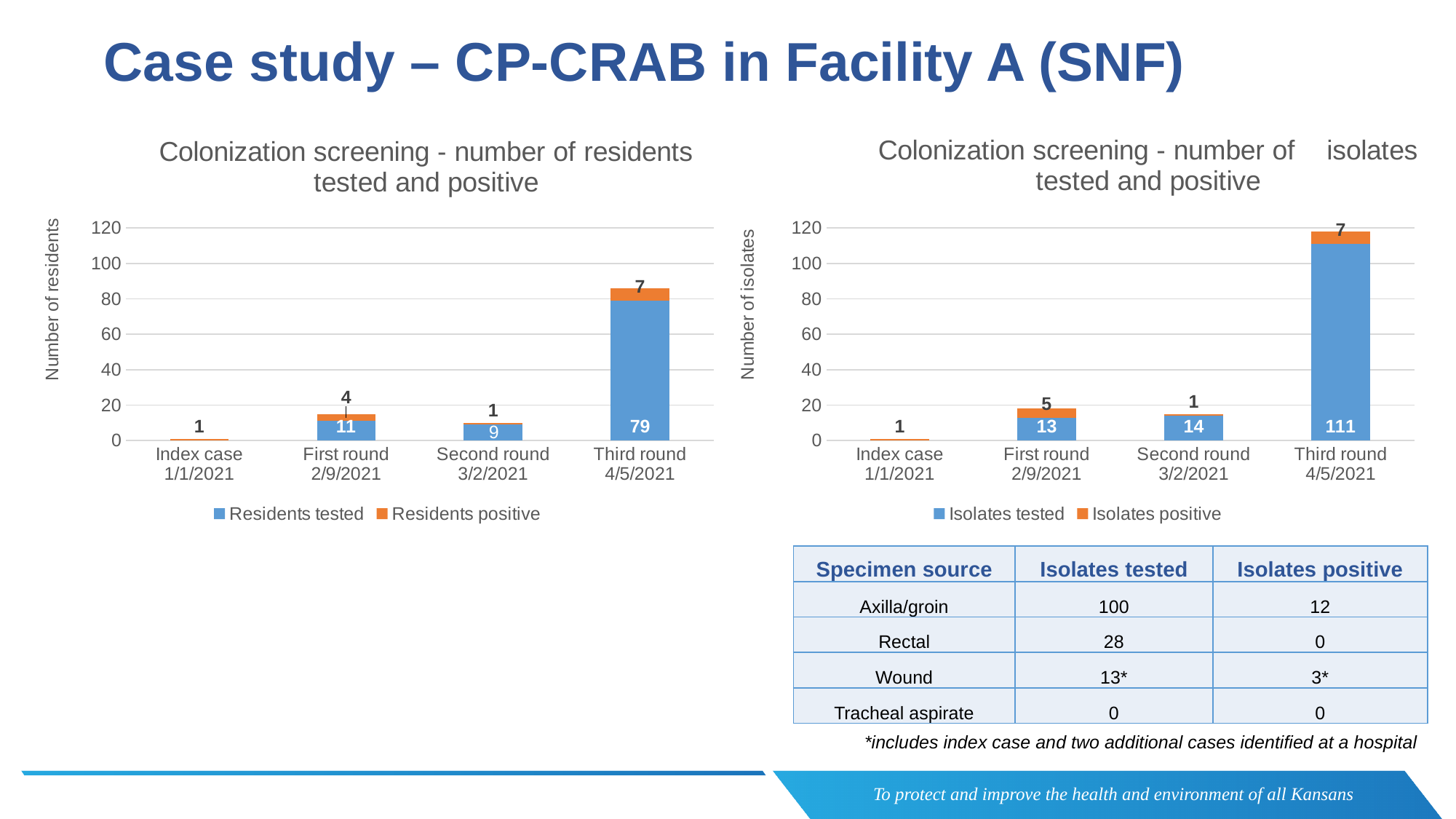
How many series does the legend list in the chart titled 'Colonization screening - number of residents tested and positive'? 2 In the chart titled 'Colonization screening - number of isolates tested and positive', how many isolates were tested in the Second round 3/2/2021? 14 In the chart titled 'Colonization screening - number of isolates tested and positive', what is the total height of the stacked bar for the Third round 4/5/2021 (isolates tested plus isolates positive)? 118 In the chart titled 'Colonization screening - number of isolates tested and positive', how many isolates were positive in the First round 2/9/2021? 5 In the chart titled 'Colonization screening - number of residents tested and positive', what is the total height of the stacked bar for the First round 2/9/2021 (residents tested plus residents positive)? 15 In the chart titled 'Colonization screening - number of residents tested and positive', which round has the highest number of residents tested? Third round 4/5/2021 What kind of chart is the chart titled 'Colonization screening - number of isolates tested and positive'? Stacked bar chart In the chart titled 'Colonization screening - number of isolates tested and positive', is the value for isolates tested in the Third round 4/5/2021 greater or less than 100? greater In the chart titled 'Colonization screening - number of residents tested and positive', how many residents were positive in the First round 2/9/2021? 4 In the chart titled 'Colonization screening - number of isolates tested and positive', what is the difference between isolates tested in the Third round 4/5/2021 and the First round 2/9/2021? 98 In the chart titled 'Colonization screening - number of residents tested and positive', which is larger: residents tested in the First round 2/9/2021 or in the Second round 3/2/2021? First round 2/9/2021 In the chart titled 'Colonization screening - number of residents tested and positive', how many residents were tested in the Third round 4/5/2021? 79